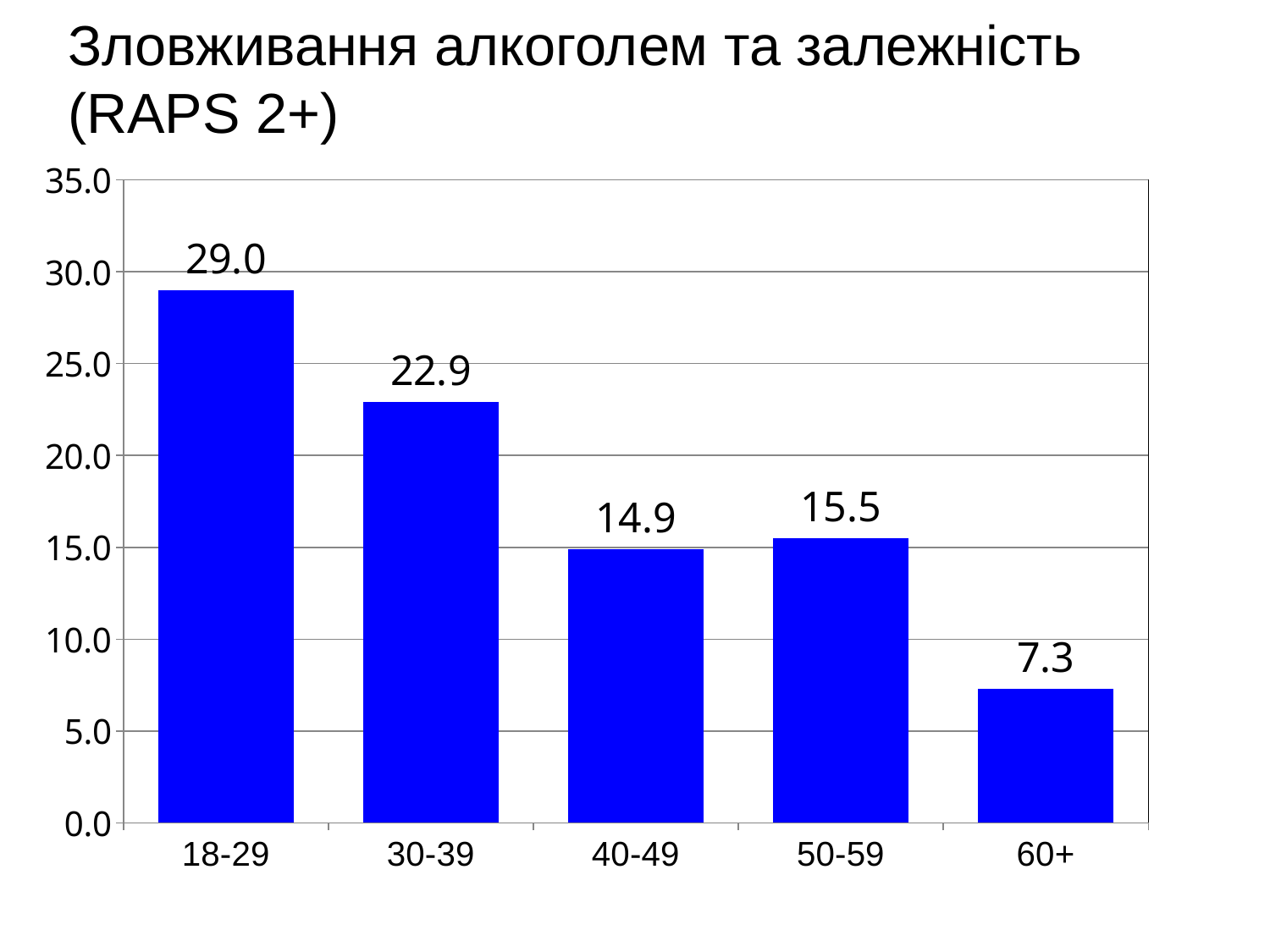
Which age group has the lowest value? 60+ Which age group has the highest value? 18-29 What is the difference between the values for 50-59 and 60+? 8.2 What is the value for the 60+ age group? 7.3 What is the value for the 40-49 age group? 14.9 What is the value for the 18-29 age group? 29.0 What is the title of the slide? Зловживання алкоголем та залежність (RAPS 2+) Which is larger, the value for 40-49 or the value for 50-59? 50-59 Is the value for 30-39 greater or less than 20.0? greater What is the difference between the values for 18-29 and 30-39? 6.1 How many age groups are shown on the chart? 5 What kind of chart is shown on the slide? bar chart